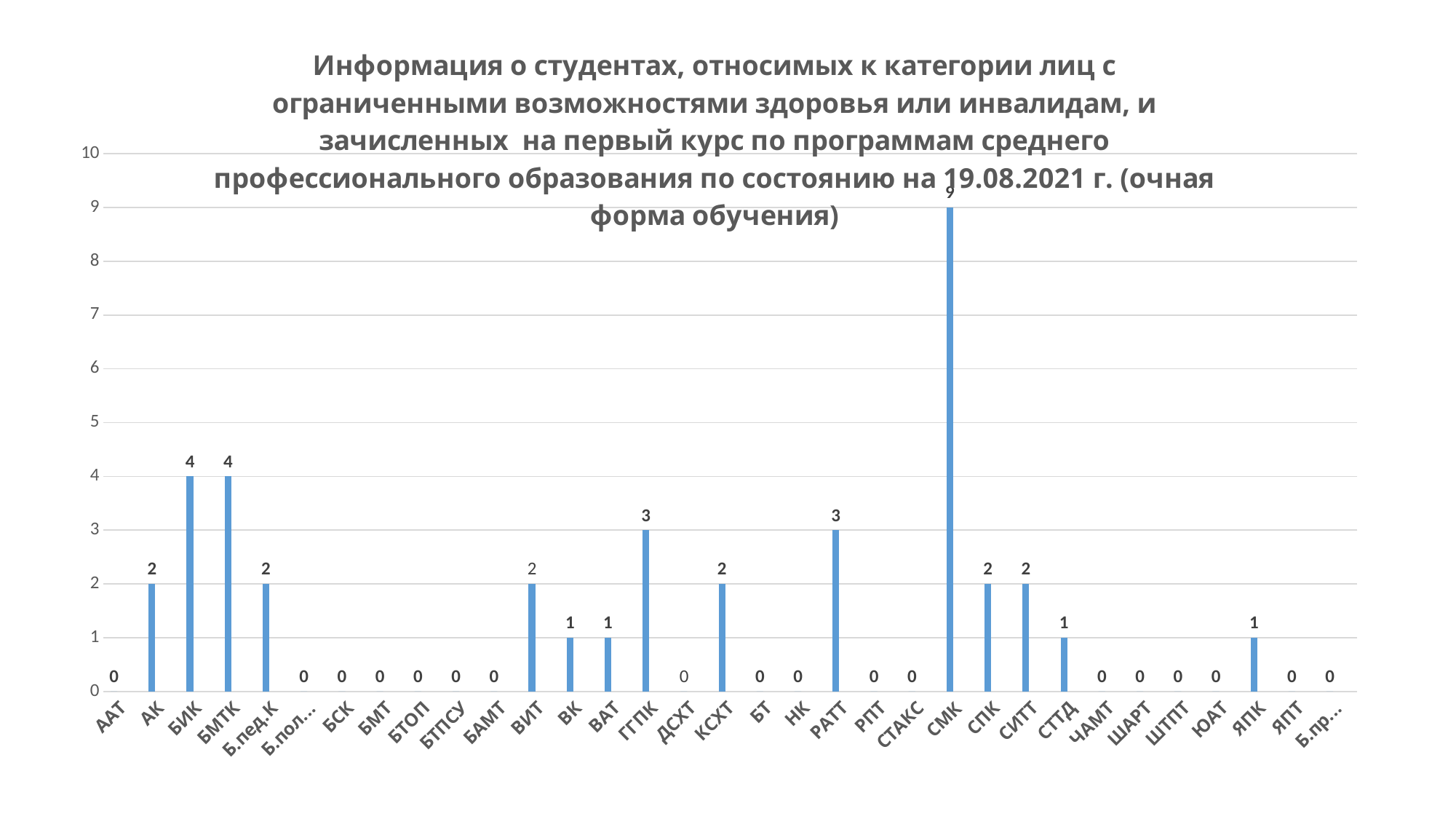
What is the value for ГГПК? 3 What is the value for СТТД? 1 Is the value for СМК greater or less than 5? greater Which is larger, the value for ГГПК or the value for КСХТ? ГГПК How many categories are shown on the x axis? 33 Which category has the highest value? СМК What is the difference between the values for СМК and БМТК? 5 What kind of chart is this? bar chart What is the value for СМК? 9 What is the value for БИК? 4 What is the value for ЯПК? 1 What is the highest value shown on the vertical axis? 10